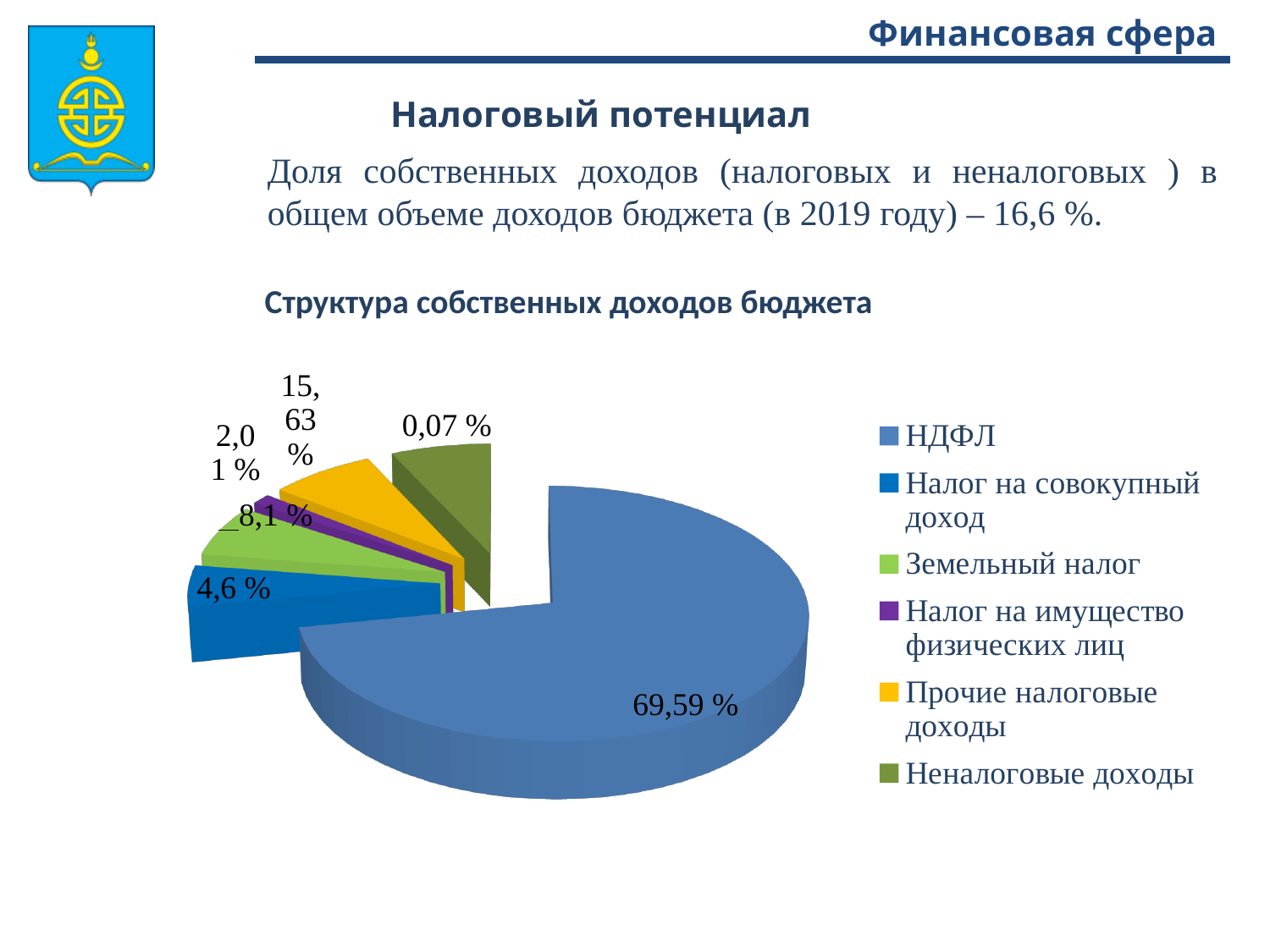
What share of the pie does Земельный налог have? 8,1 % What share of the pie does Налог на имущество физических лиц have? 2,01 % What is the title of the chart? Структура собственных доходов бюджета What share of the pie does НДФЛ have? 69,59 % How many categories does the legend of the pie chart list? 6 What kind of chart is shown on the slide? pie chart What is the difference between the share of НДФЛ and the share of Прочие налоговые доходы? 53,96 % What share of the pie does Налог на совокупный доход have? 4,6 % Which is larger: the share of Земельный налог or the share of Налог на совокупный доход? Земельный налог Which category has the largest share of the pie? НДФЛ What share of the pie does Прочие налоговые доходы have? 15,63 % Which colour represents Прочие налоговые доходы in the legend? yellow